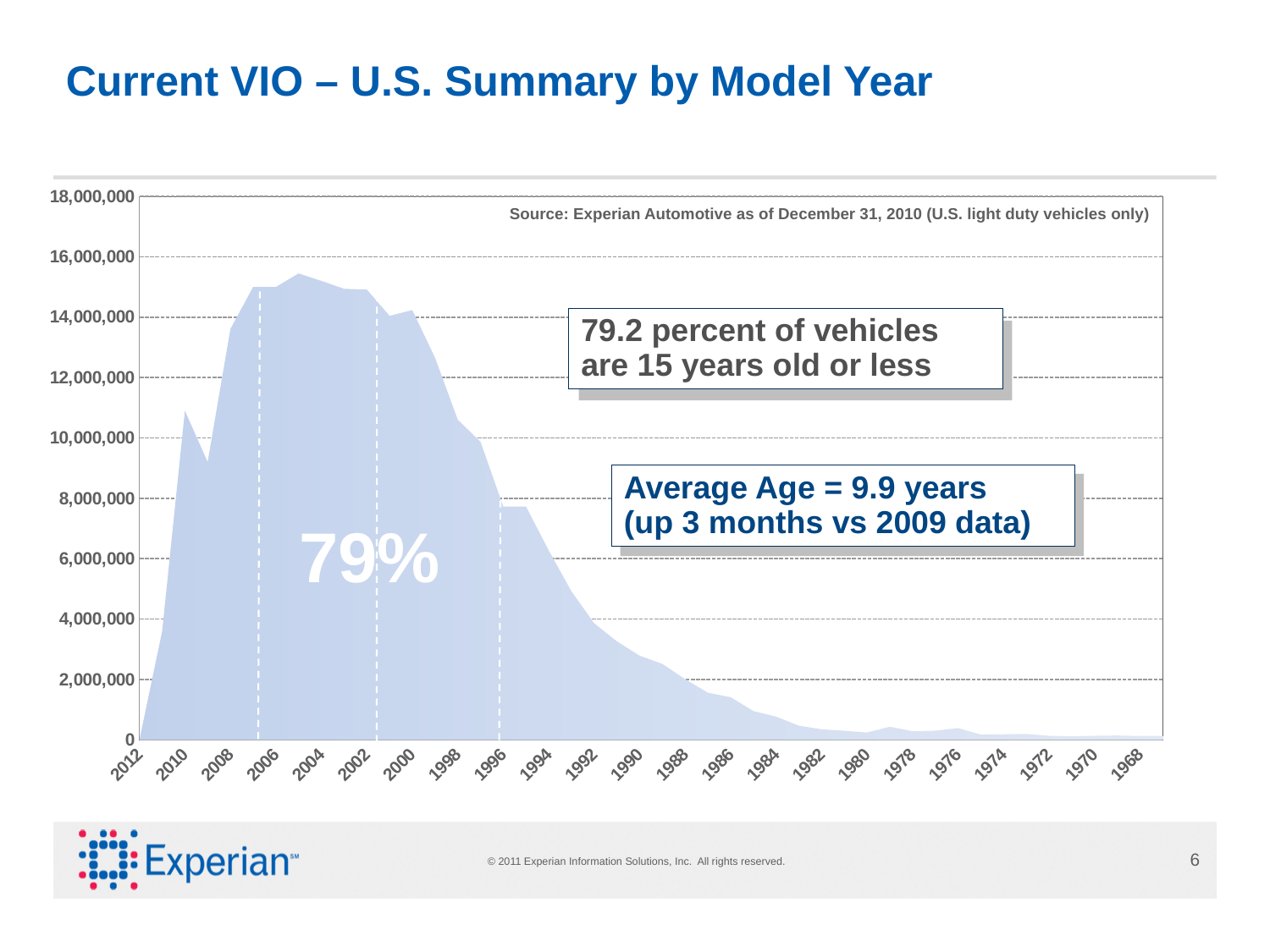
Is the value for model year 2010 greater or less than 10,000,000? greater Which model year has the larger value, 2010 or 1994? 2010 What is the highest value shown on the y axis? 18,000,000 How many model year labels are shown on the x axis? 23 Is the value for model year 1996 greater or less than 8,000,000? less According to the annotation on the chart, what is the average vehicle age? 9.9 years What kind of chart is shown on the slide? area chart Is the value for model year 2012 greater or less than 2,000,000? less Do the values rise or fall along the x axis from model year 2004 to model year 1968? fall Which model year has the larger value, 2008 or 1990? 2008